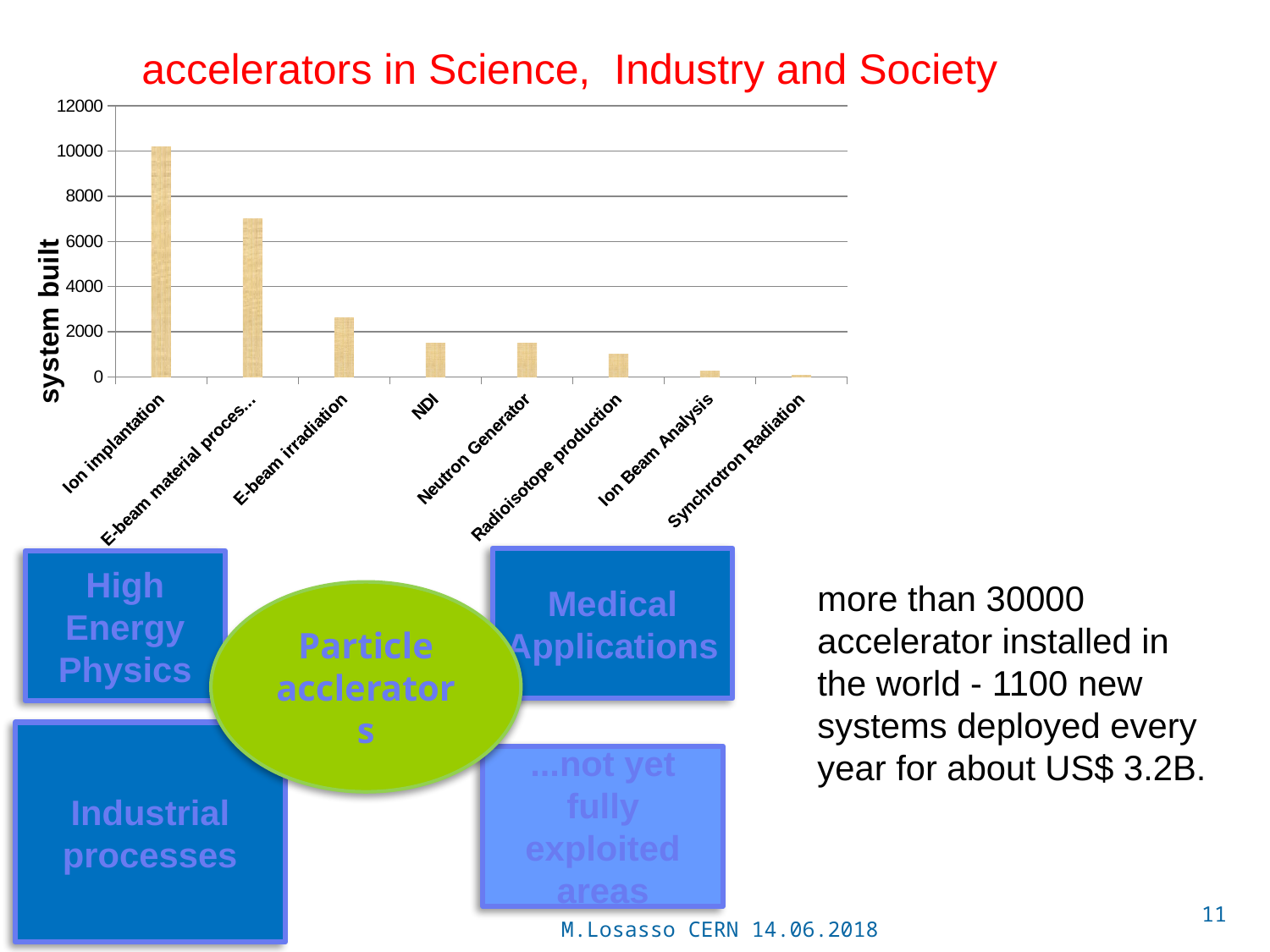
Which is larger, the value for Ion implantation or the value for E-beam material processing? Ion implantation Which category has the lowest number of systems built? Synchrotron Radiation How many categories are shown on the x axis of the chart? 8 What kind of chart is shown on the slide? bar chart Is the value for E-beam irradiation greater or less than 4000? less Is the value for NDI greater or less than 2000? less Which category has the highest number of systems built? Ion implantation Is the value for E-beam material processing greater or less than 6000? greater Which is larger, the value for E-beam irradiation or the value for Radioisotope production? E-beam irradiation Do the values rise or fall from left to right along the x axis? fall